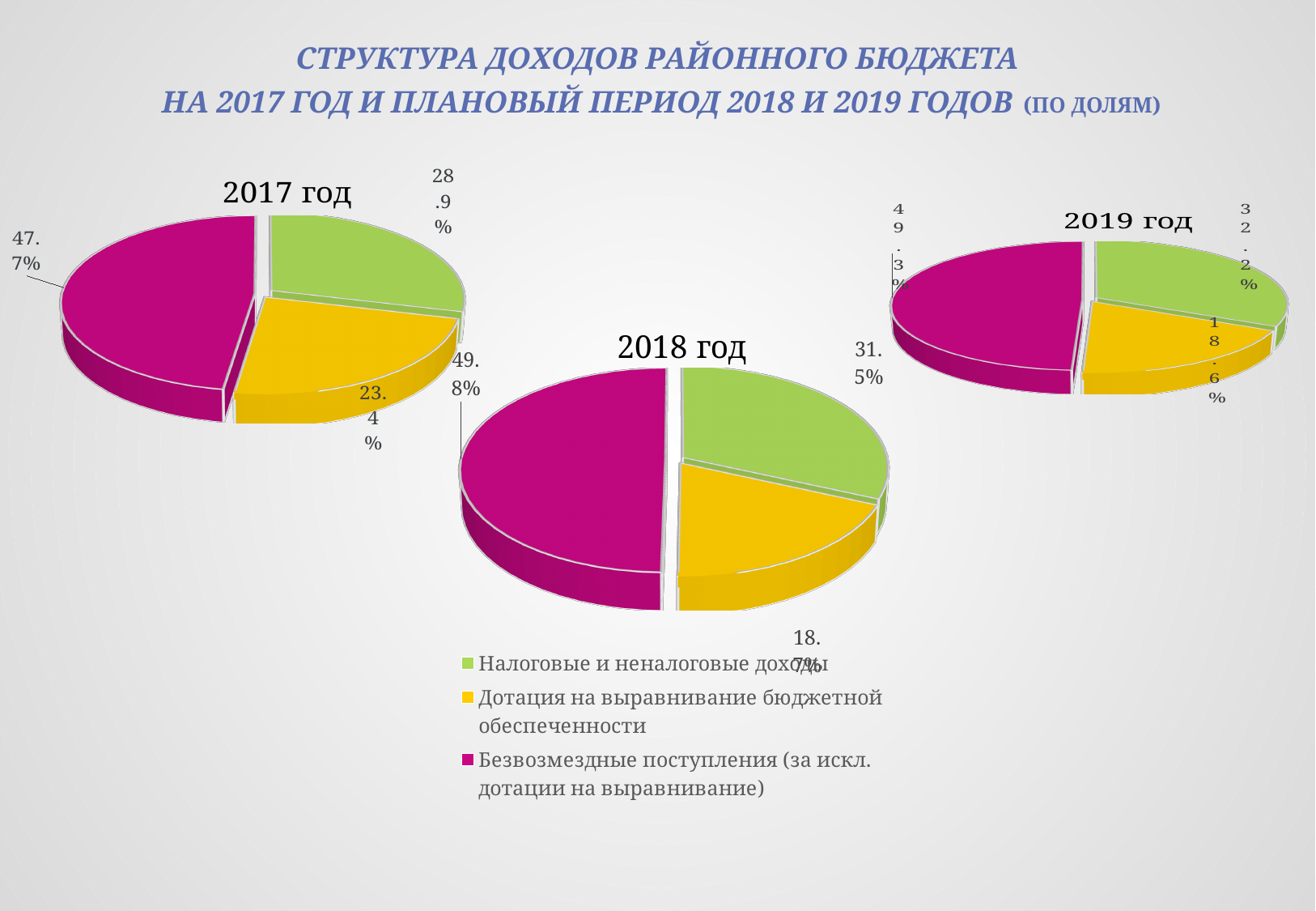
In the 2018 год pie chart, which category has the smallest share? Дотация на выравнивание бюджетной обеспеченности How many pie charts are shown on the slide? 3 What colour represents Дотация на выравнивание бюджетной обеспеченности in the legend? Yellow In the 2017 год pie chart, what is the difference between the shares of Безвозмездные поступления (за искл. дотации на выравнивание) and Налоговые и неналоговые доходы? 18.8% In the 2019 год pie chart, which category has the largest share? Безвозмездные поступления (за искл. дотации на выравнивание) In the 2017 год pie chart, what share is shown for Безвозмездные поступления (за искл. дотации на выравнивание)? 47.7% In the 2018 год pie chart, what share is shown for Налоговые и неналоговые доходы? 31.5% In the 2018 год pie chart, what share is shown for Безвозмездные поступления (за искл. дотации на выравнивание)? 49.8% Which is larger: the share of Налоговые и неналоговые доходы in 2018 год or in 2019 год? 2019 год In the 2017 год pie chart, what share is shown for Налоговые и неналоговые доходы? 28.9% In the 2019 год pie chart, what share is shown for Дотация на выравнивание бюджетной обеспеченности? 18.6% In the 2017 год pie chart, what share is shown for Дотация на выравнивание бюджетной обеспеченности? 23.4%